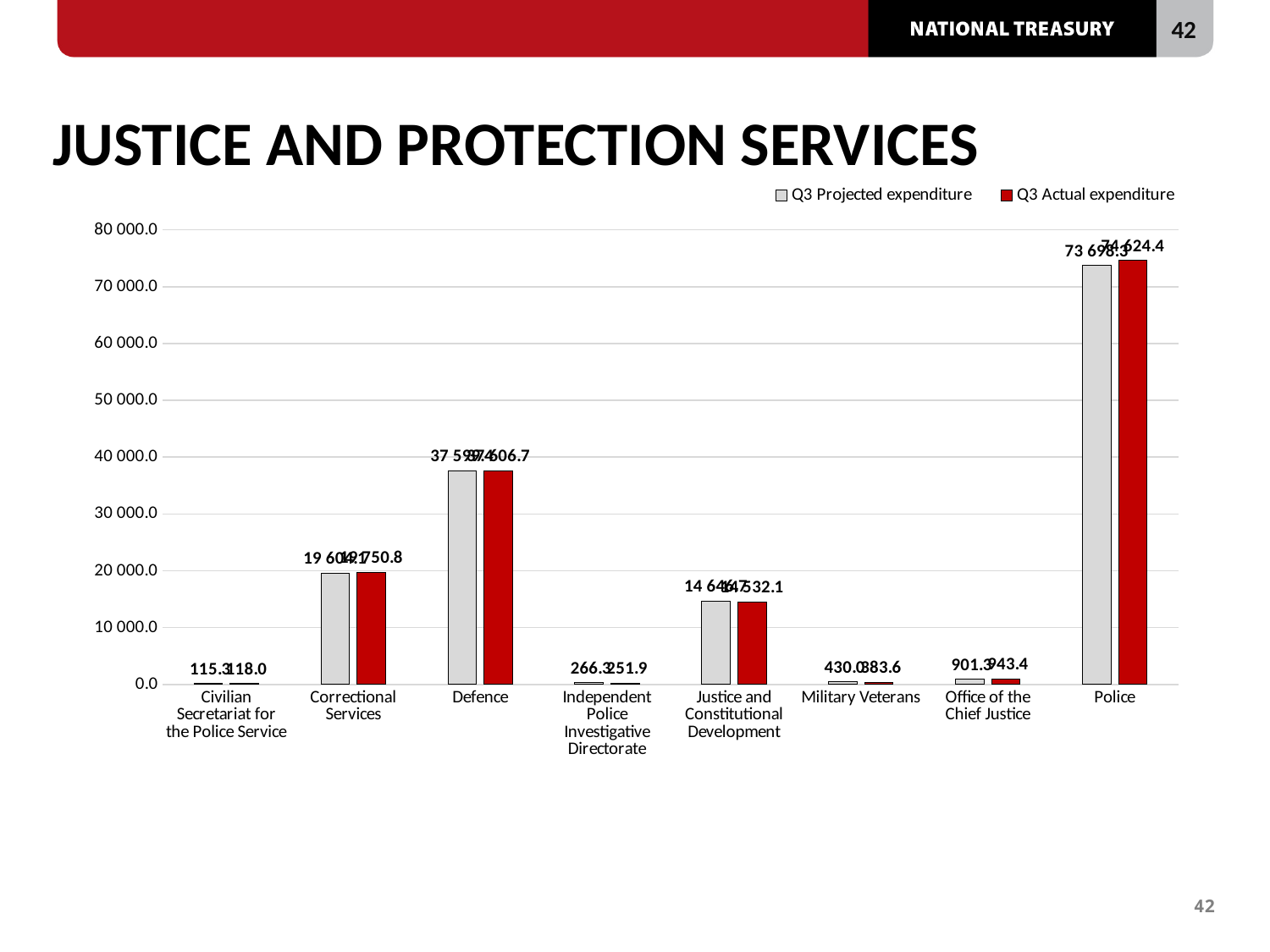
Is the Q3 Actual expenditure for Police greater or less than 70 000.0? greater Which category has the lowest Q3 Actual expenditure? Civilian Secretariat for the Police Service How many categories are shown on the x axis? 8 Which category has the highest Q3 Projected expenditure? Police What is the Q3 Actual expenditure for the Civilian Secretariat for the Police Service? 118.0 For Military Veterans, which is larger: Q3 Projected expenditure or Q3 Actual expenditure? Q3 Projected expenditure What kind of chart is shown on the slide? bar chart What is the Q3 Projected expenditure for the Independent Police Investigative Directorate? 266.3 What is the difference between Q3 Actual and Q3 Projected expenditure for the Office of the Chief Justice? 42.1 What is the Q3 Projected expenditure for the Office of the Chief Justice? 901.3 How many series does the legend list? 2 What is the Q3 Actual expenditure for Military Veterans? 383.6